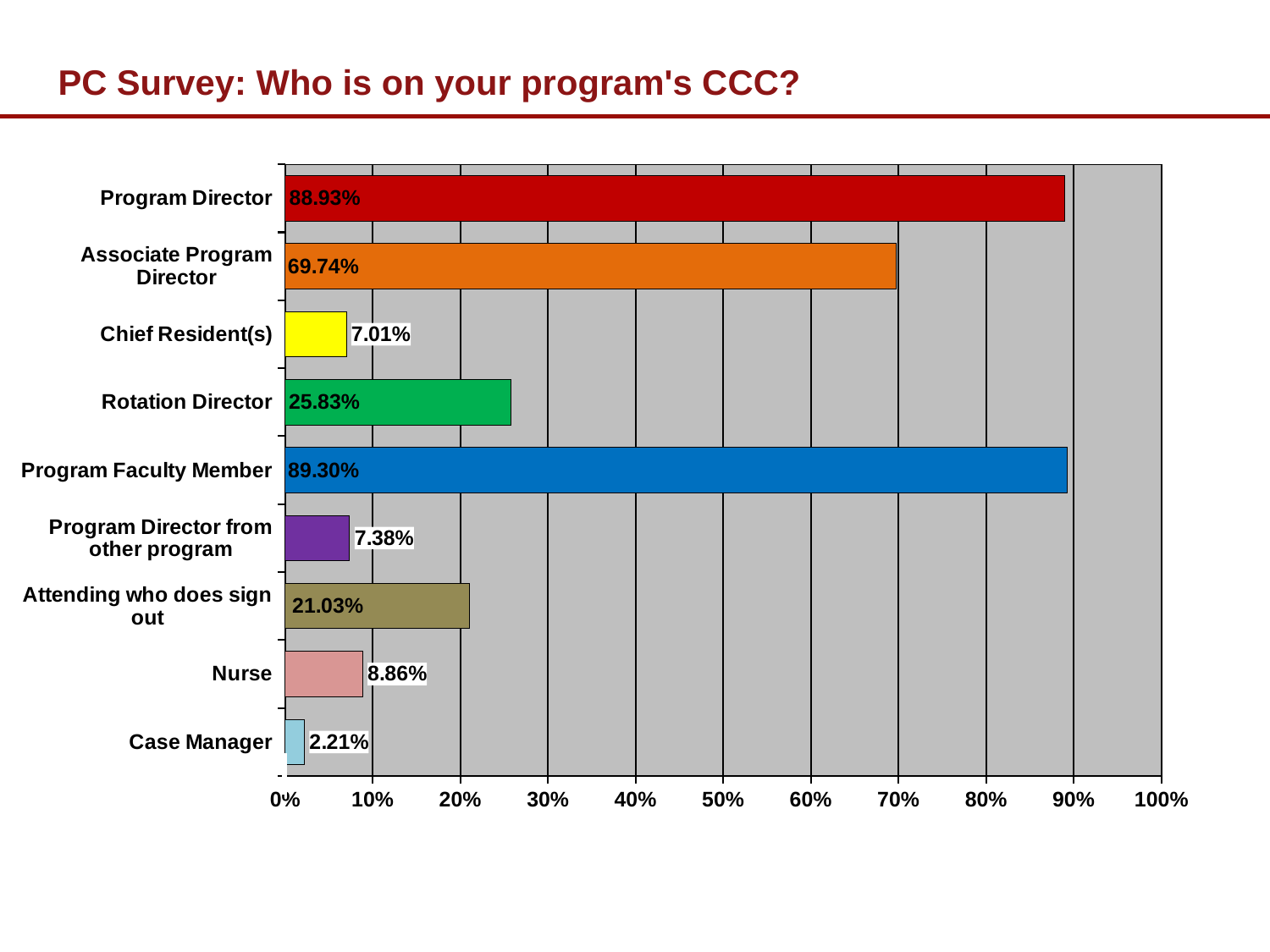
How many categories are shown in the chart? 9 What percentage of programs have the Program Director on their CCC? 88.93% What is the value shown for Rotation Director? 25.83% Which category has the lowest value? Case Manager Is the value for Associate Program Director greater or less than 60%? greater What is the value shown for Attending who does sign out? 21.03% Which is larger, the value for Chief Resident(s) or the value for Program Director from other program? Program Director from other program What is the difference between the values for Rotation Director and Attending who does sign out? 4.80% What is the difference between the values for Program Director and Associate Program Director? 19.19% Which category has the highest value? Program Faculty Member What kind of chart is shown on the slide? Bar chart What is the value shown for Nurse? 8.86%